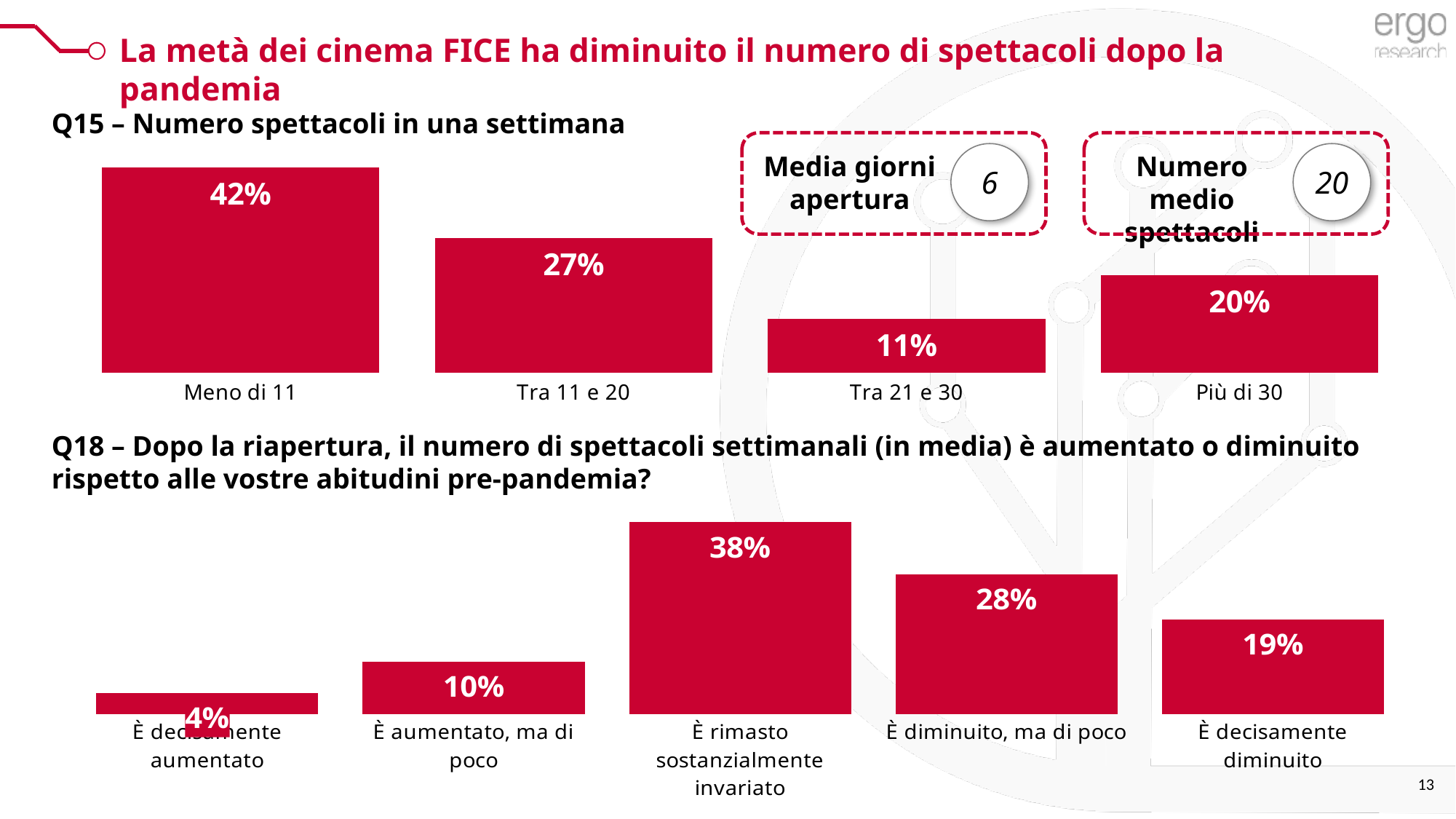
In the Q18 chart, how many categories are shown? 5 In the Q18 chart (Dopo la riapertura...), what is the value for 'È rimasto sostanzialmente invariato'? 38% What type of chart is used for Q15? Bar chart In the Q15 chart, what is the difference between 'Meno di 11' and 'Tra 11 e 20'? 15 percentage points In the Q15 chart, how many categories are shown? 4 In the Q18 chart, what is the difference between 'È diminuito, ma di poco' and 'È aumentato, ma di poco'? 18 percentage points In the Q18 chart, which category has the highest value? È rimasto sostanzialmente invariato In the Q18 chart, what is the value for 'È decisamente aumentato'? 4% In the Q15 chart, which category has the lowest value? Tra 21 e 30 In the Q18 chart, which is larger: 'È diminuito, ma di poco' or 'È decisamente diminuito'? È diminuito, ma di poco In the Q15 chart (Numero spettacoli in una settimana), what is the value for 'Meno di 11'? 42% In the Q15 chart, what is the value for 'Più di 30'? 20%